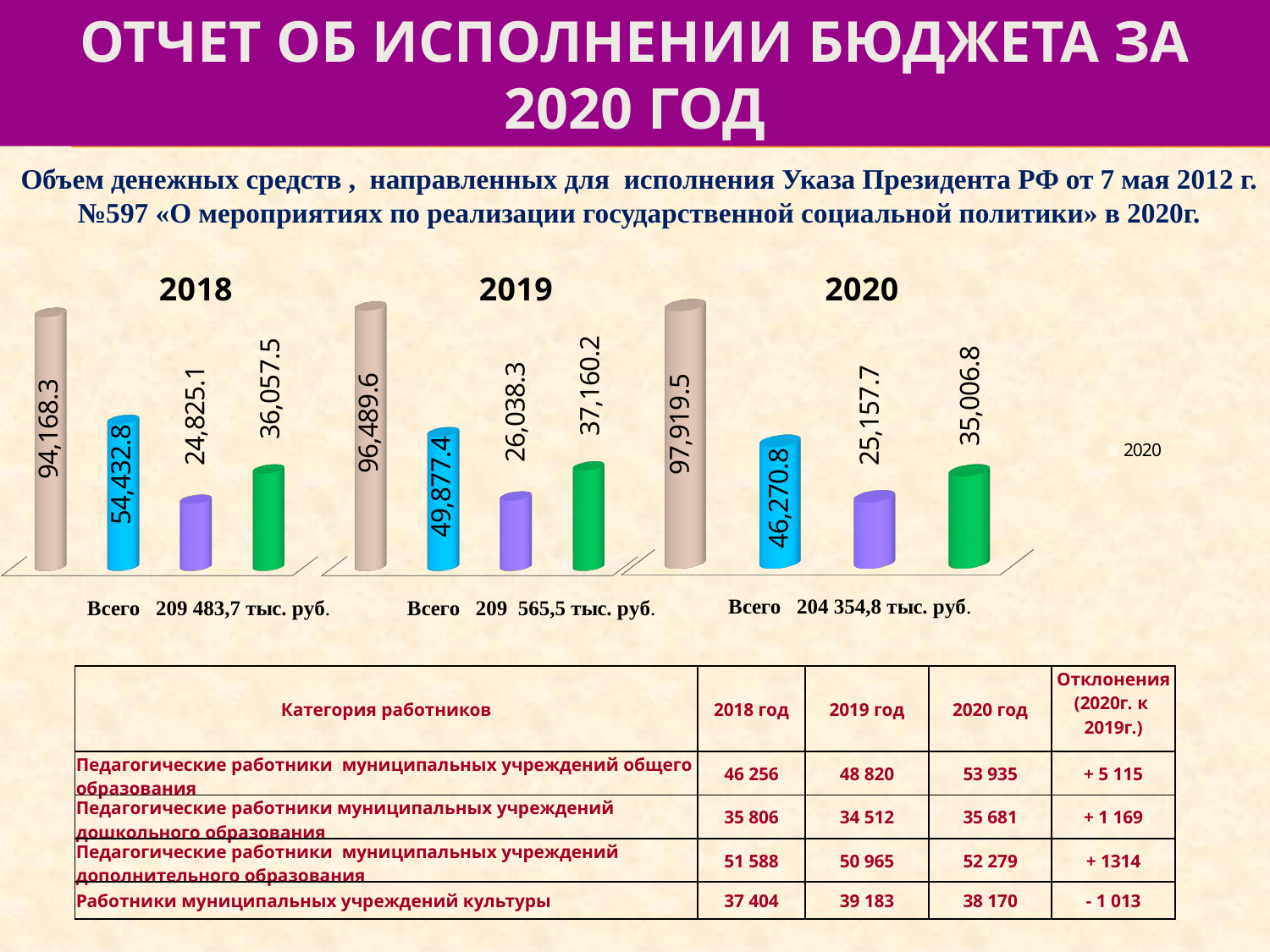
In the 2020 chart, what value is shown on the purple bar? 25,157.7 How many bars are plotted in the 2019 chart? 4 In the 2018 chart, what value is shown on the tallest (beige) bar? 94,168.3 Which is larger: the blue bar in the 2018 chart or the blue bar in the 2020 chart? The blue bar in the 2018 chart (54,432.8) In the 2020 chart, what value is shown on the green bar? 35,006.8 In the 2018 chart, which bar has the lowest value? The purple bar, 24,825.1 Does the value of the tallest (beige) bar rise or fall from the 2018 chart to the 2020 chart? Rises In the 2018 chart, what is the difference between the beige bar (94,168.3) and the blue bar (54,432.8)? 39,735.5 What type of chart is used for the 2018, 2019 and 2020 data? Bar chart In the 2019 chart, what value is shown on the blue bar? 49,877.4 In the 2019 chart, which bar has the highest value? The beige bar, 96,489.6 In the 2020 chart, what is the difference between the green bar (35,006.8) and the purple bar (25,157.7)? 9,849.1